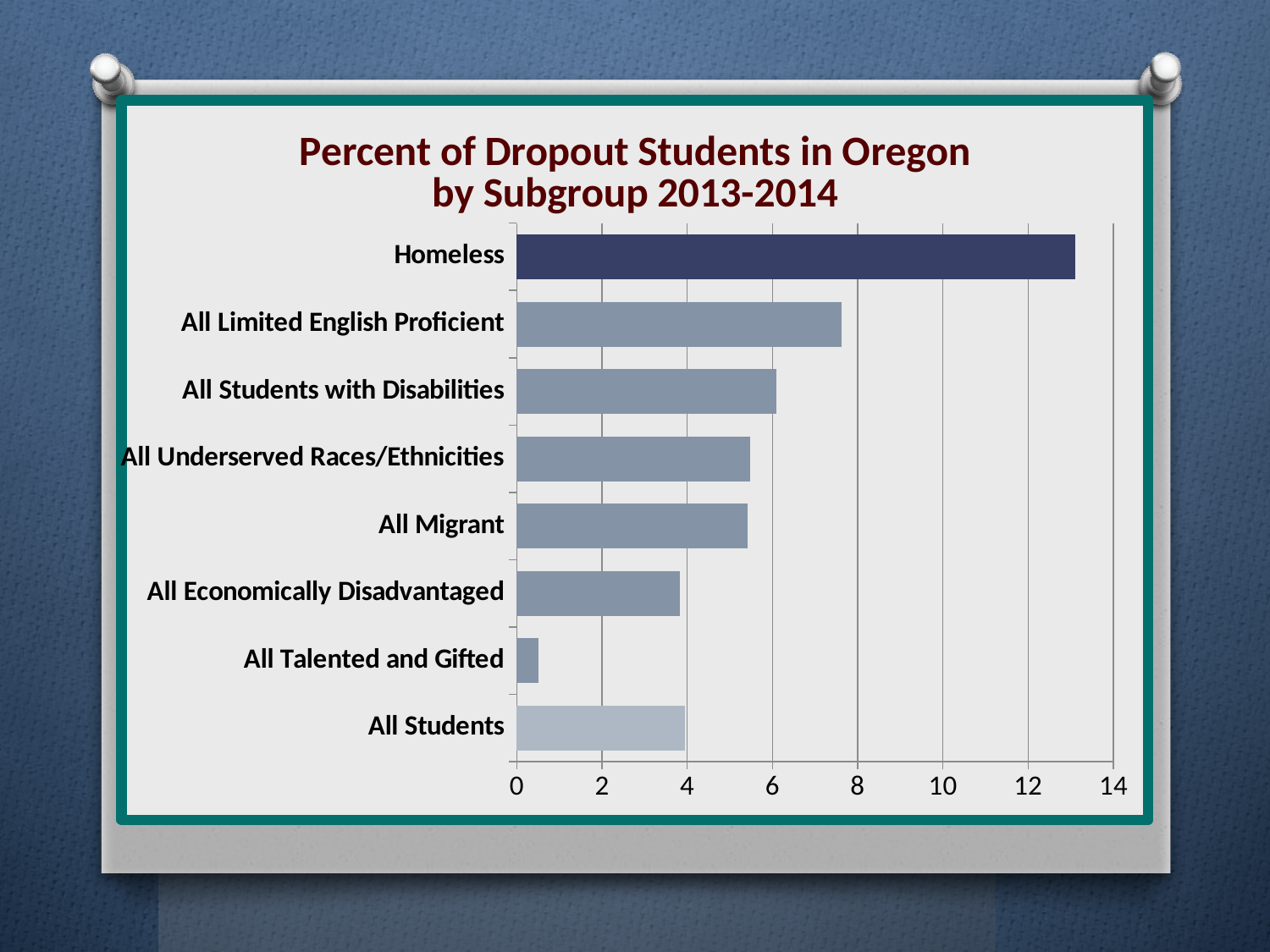
Is the value for All Economically Disadvantaged greater or less than 4? less Which is larger, the value for All Students with Disabilities or the value for All Migrant? All Students with Disabilities Is the value for All Underserved Races/Ethnicities greater or less than 4? greater Is the value for All Limited English Proficient greater or less than 8? less Which subgroup has the highest percent of dropout students? Homeless Which subgroup has the lowest percent of dropout students? All Talented and Gifted How many subgroups are plotted in the chart? 8 What kind of chart is shown on the slide? bar chart What is the title of the chart? Percent of Dropout Students in Oregon by Subgroup 2013-2014 Which is larger, the value for Homeless or the value for All Limited English Proficient? Homeless